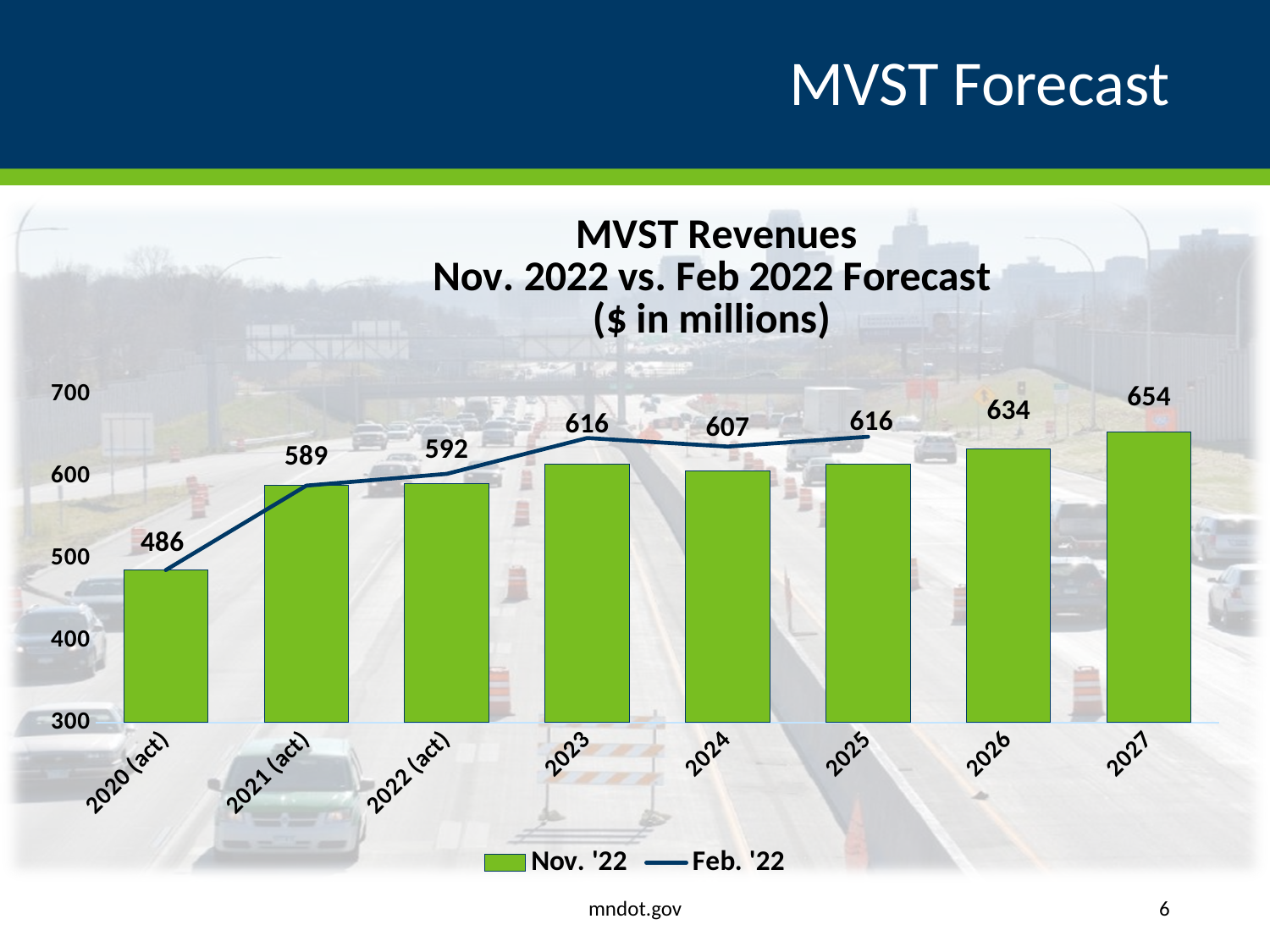
What is the Nov. '22 value for 2024? 607 What kind of chart is used for the Nov. '22 series? bar chart Which year has the highest Nov. '22 value? 2027 What is the difference between the Nov. '22 values for 2027 and 2020 (act)? 168 Is the Feb. '22 line value for 2023 greater or less than 600? greater What is the Nov. '22 value for 2020 (act)? 486 How many years are shown on the x axis? 8 Which year has the lowest Nov. '22 value? 2020 (act) What is the title of the chart? MVST Revenues Nov. 2022 vs. Feb 2022 Forecast ($ in millions) What is the Nov. '22 value for 2027? 654 Which is larger, the Nov. '22 value for 2023 or for 2024? 2023 How many series does the legend list? 2